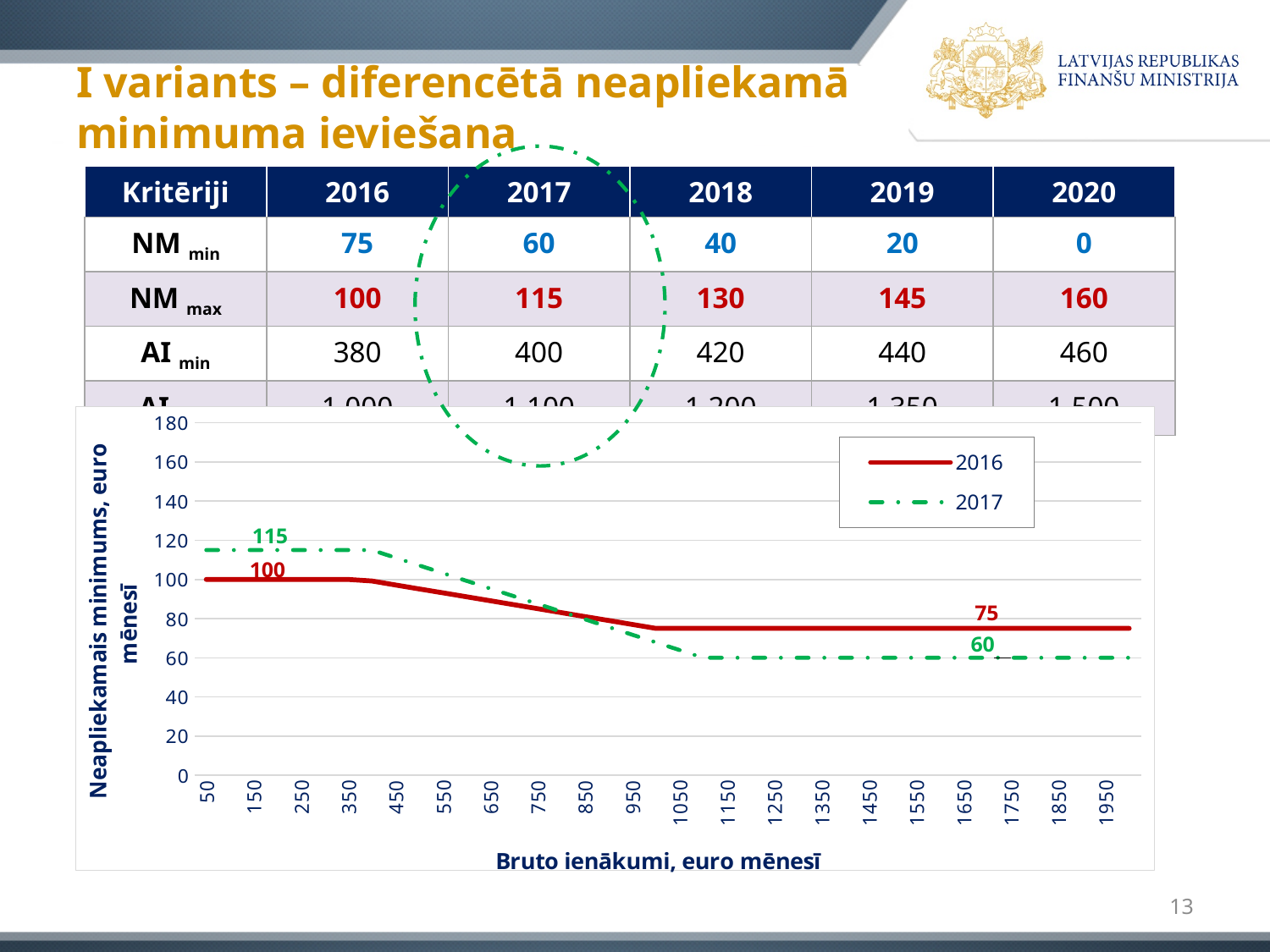
What is the difference between the labelled minimum values of the 2016 series (75) and the 2017 series (60)? 15 What is the title of the x axis of the chart? Bruto ienākumi, euro mēnesī What is the maximum value of the 2016 series, as labelled on the chart? 100 What is the difference between the labelled maximum values of the 2017 series (115) and the 2016 series (100)? 15 What kind of chart is shown on the slide? line chart What is the minimum value the 2016 series levels off at, as labelled on the chart? 75 Which series has the higher value at a gross income of 1950 euro per month, 2016 or 2017? 2016 Which series has the higher value at a gross income of 50 euro per month, 2016 or 2017? 2017 What is the minimum value the 2017 series levels off at, as labelled on the chart? 60 How many series does the chart legend list? 2 Do the values of the 2016 series rise or fall as gross income increases from 350 to 1050 euro per month? fall What is the maximum value of the 2017 series, as labelled on the chart? 115